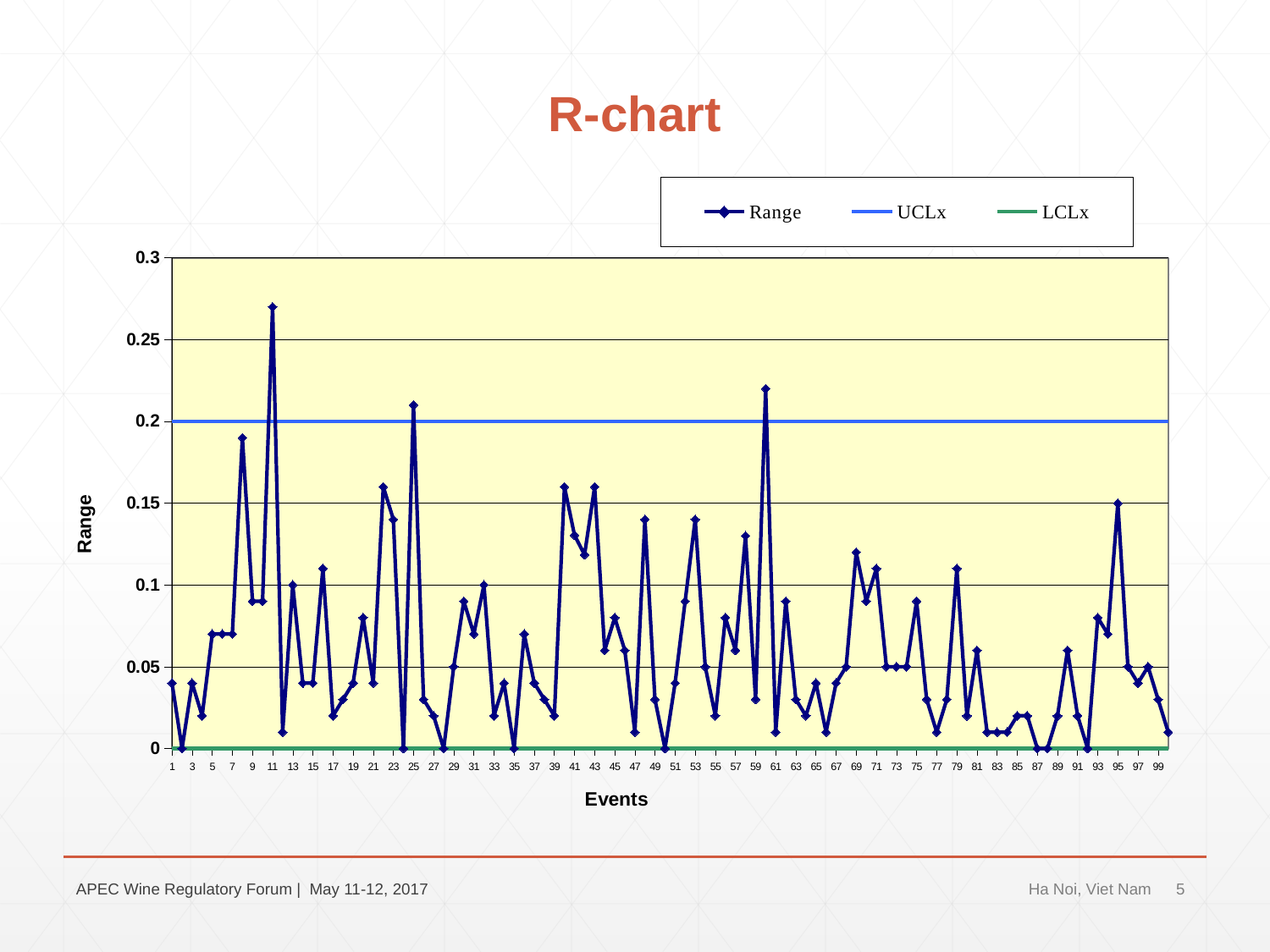
Is the Range value at event 11 greater or less than 0.25? greater What is the value of the UCLx line? 0.2 Is the Range value at event 1 greater or less than 0.05? less What kind of chart is shown on the slide? line chart Is the Range value at event 25 greater or less than 0.2? greater What is the title of the chart? R-chart At which event does the Range series reach its highest value? 11 What is the label of the x axis? Events What is the value of the LCLx line? 0 How many series does the legend list? 3 Which has the larger Range value, event 11 or event 60? event 11